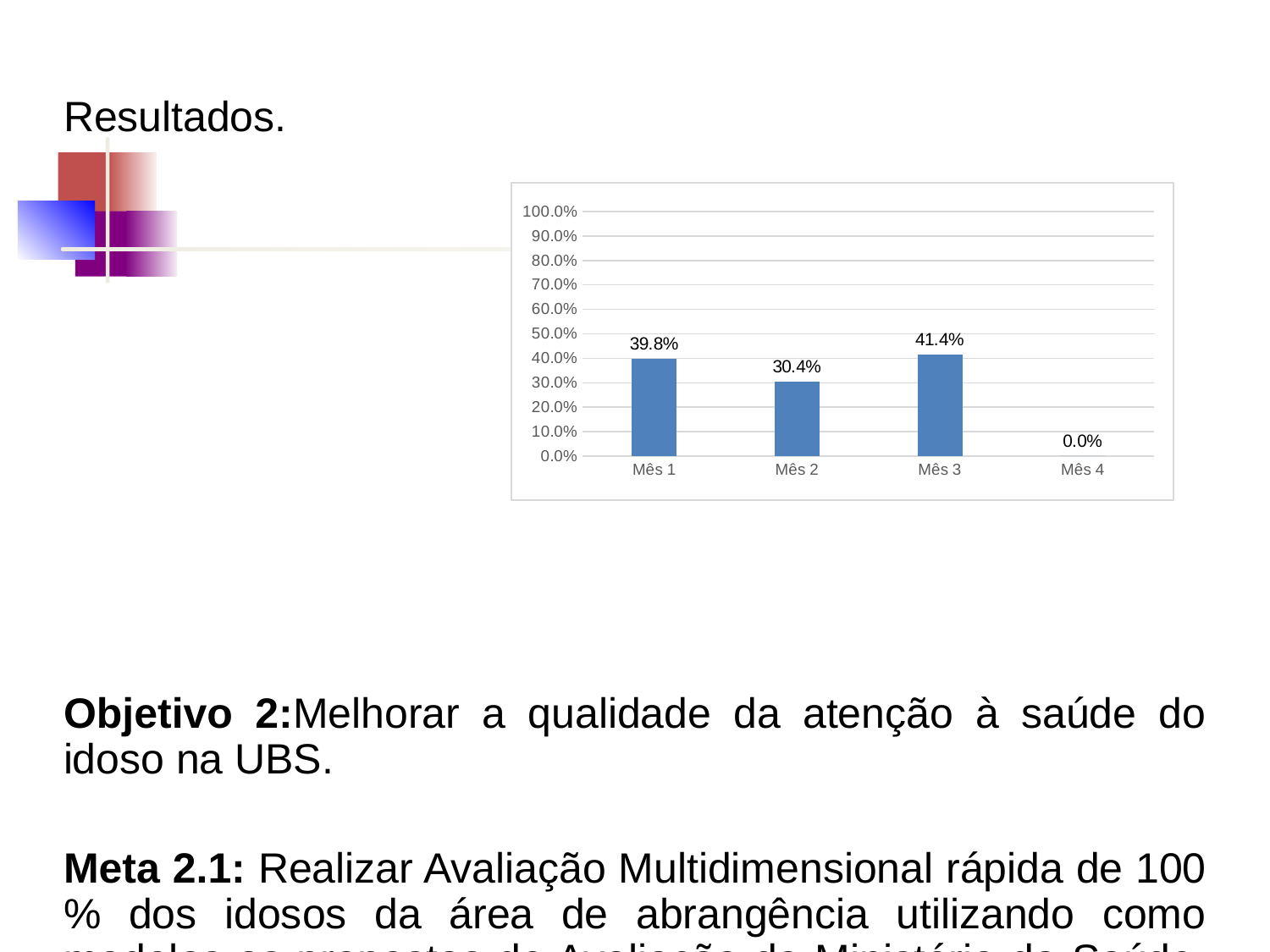
What is the value for Mês 1? 39.8% What is the difference between the values for Mês 3 and Mês 2? 11.0% What kind of chart is shown on the slide? bar chart Which month has the lowest value? Mês 4 What is the maximum value shown on the y axis? 100.0% What is the value for Mês 3? 41.4% Which month has the highest value? Mês 3 What is the value for Mês 2? 30.4% Is the value for Mês 3 greater or less than 50.0%? less Which is larger, the value for Mês 1 or Mês 2? Mês 1 What is the value for Mês 4? 0.0% How many categories are shown on the x axis? 4